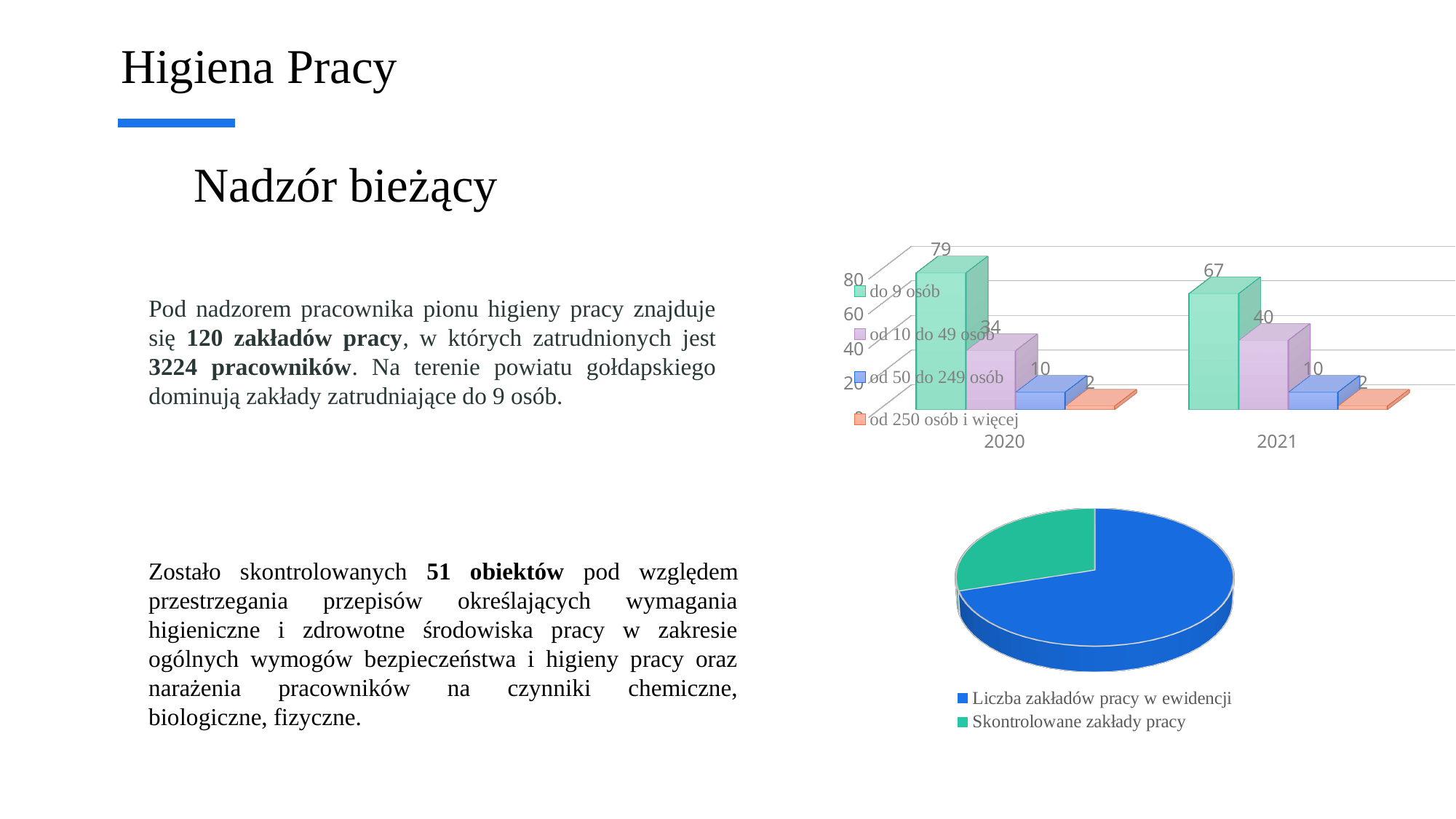
In the bar chart at the top right, which series has the lowest value in 2020? od 250 osób i więcej In the bar chart at the top right, what is the value for 'od 50 do 249 osób' in 2020? 10 In the bar chart at the top right, how many year categories are shown on the x axis? 2 What kind of chart is shown at the bottom right of the slide? Pie chart In the bar chart at the top right, what is the value for 'od 250 osób i więcej' in 2021? 2 In the bar chart at the top right, what is the value for 'od 10 do 49 osób' in 2021? 40 In the pie chart at the bottom right, which legend entry corresponds to the green slice? Skontrolowane zakłady pracy In the bar chart at the top right, what is the difference between the 'do 9 osób' values for 2020 and 2021? 12 In the bar chart at the top right, what is the value for 'do 9 osób' in 2020? 79 In the bar chart at the top right, is the 'od 10 do 49 osób' value larger in 2020 or in 2021? 2021 In the bar chart at the top right, how many series does the legend list? 4 In the bar chart at the top right, which series has the highest value in 2021? do 9 osób